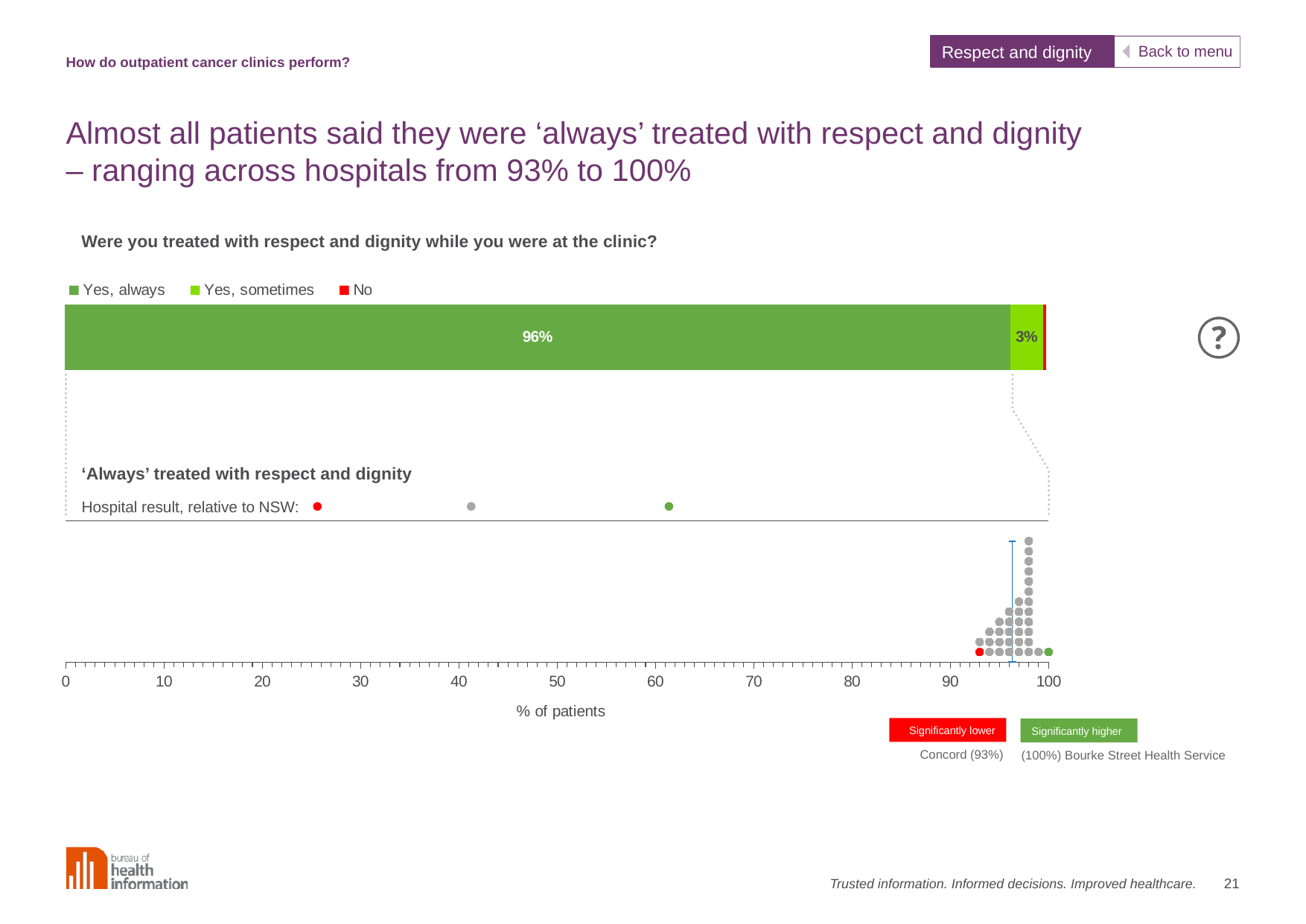
What is the difference in percentage points between 'Yes, always' and 'Yes, sometimes' in the stacked bar chart? 93 percentage points What is the difference between the Bourke Street Health Service result and the Concord result in the hospital dot plot? 7 percentage points In the hospital results dot plot, what is the result for Concord? 93% Is the value for 'Yes, always' in the stacked bar chart greater or less than 90? greater What kind of chart shows the breakdown of responses to 'Were you treated with respect and dignity while you were at the clinic?' Stacked bar chart In the stacked bar chart, what percentage of patients answered 'Yes, sometimes'? 3% Which response category has the largest share in the stacked bar chart? Yes, always Which is larger in the stacked bar chart: 'Yes, always' or 'Yes, sometimes'? Yes, always In the stacked bar chart, what percentage of patients answered 'Yes, always' to being treated with respect and dignity? 96% How many response categories does the legend of the stacked bar chart list? 3 What is the label on the horizontal axis of the hospital results dot plot? % of patients In the hospital results dot plot, what is the result for Bourke Street Health Service? 100%